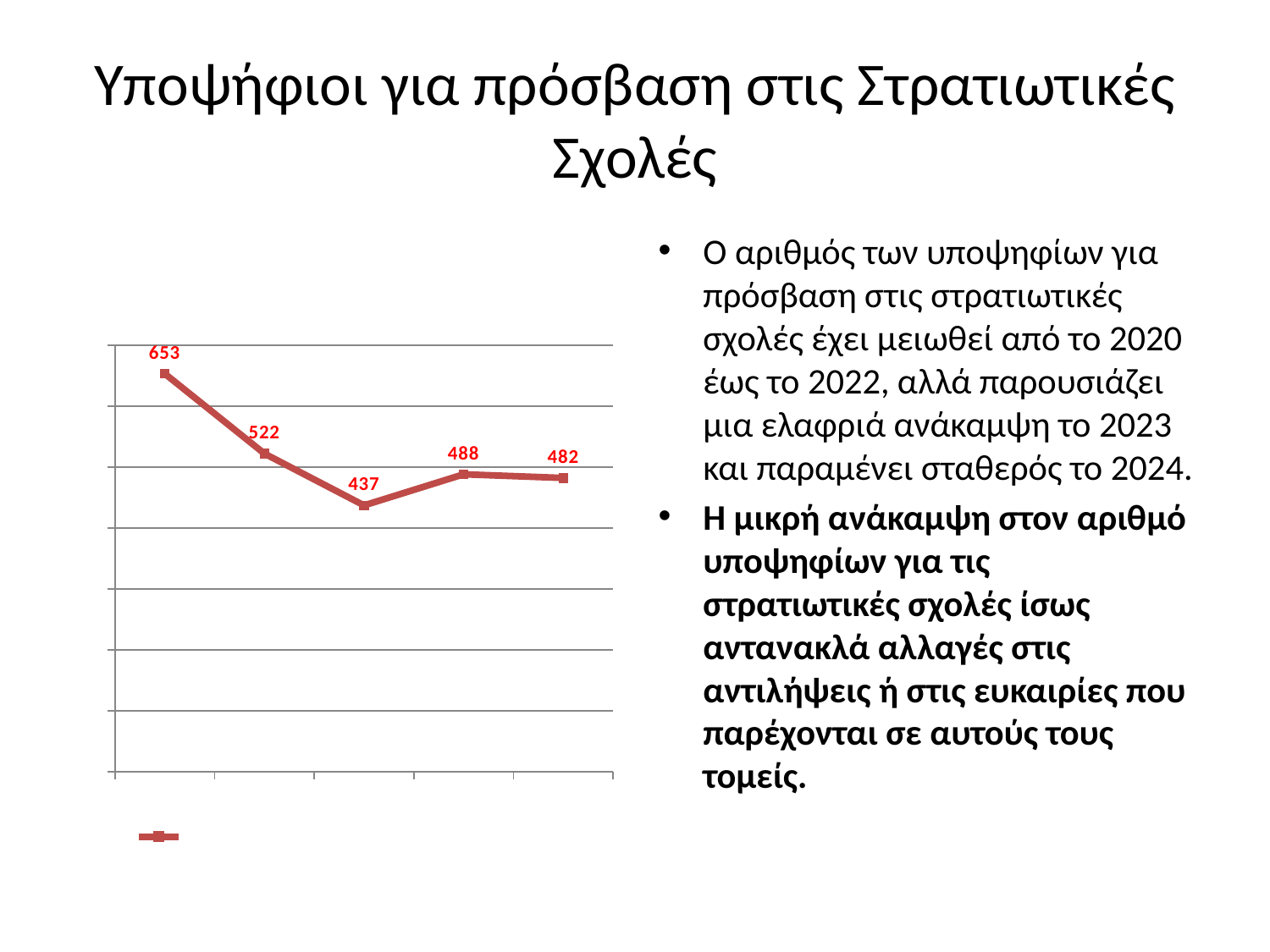
What kind of chart is shown on the slide? Line chart Do the values fall or rise from the first data point to the third data point? Fall What is the value of the first data point on the line chart? 653 What is the value of the last (fifth) data point on the line chart? 482 What is the lowest value plotted on the line chart? 437 What colour is the line plotted on the chart? Red What is the difference between the first data point (653) and the second data point (522)? 131 How many data points are plotted on the line chart? 5 By how much does the fourth data point (488) exceed the third data point (437)? 51 What is the value of the third data point on the line chart? 437 What is the highest value plotted on the line chart? 653 Which is larger, the second data point or the fourth data point? The second data point (522)